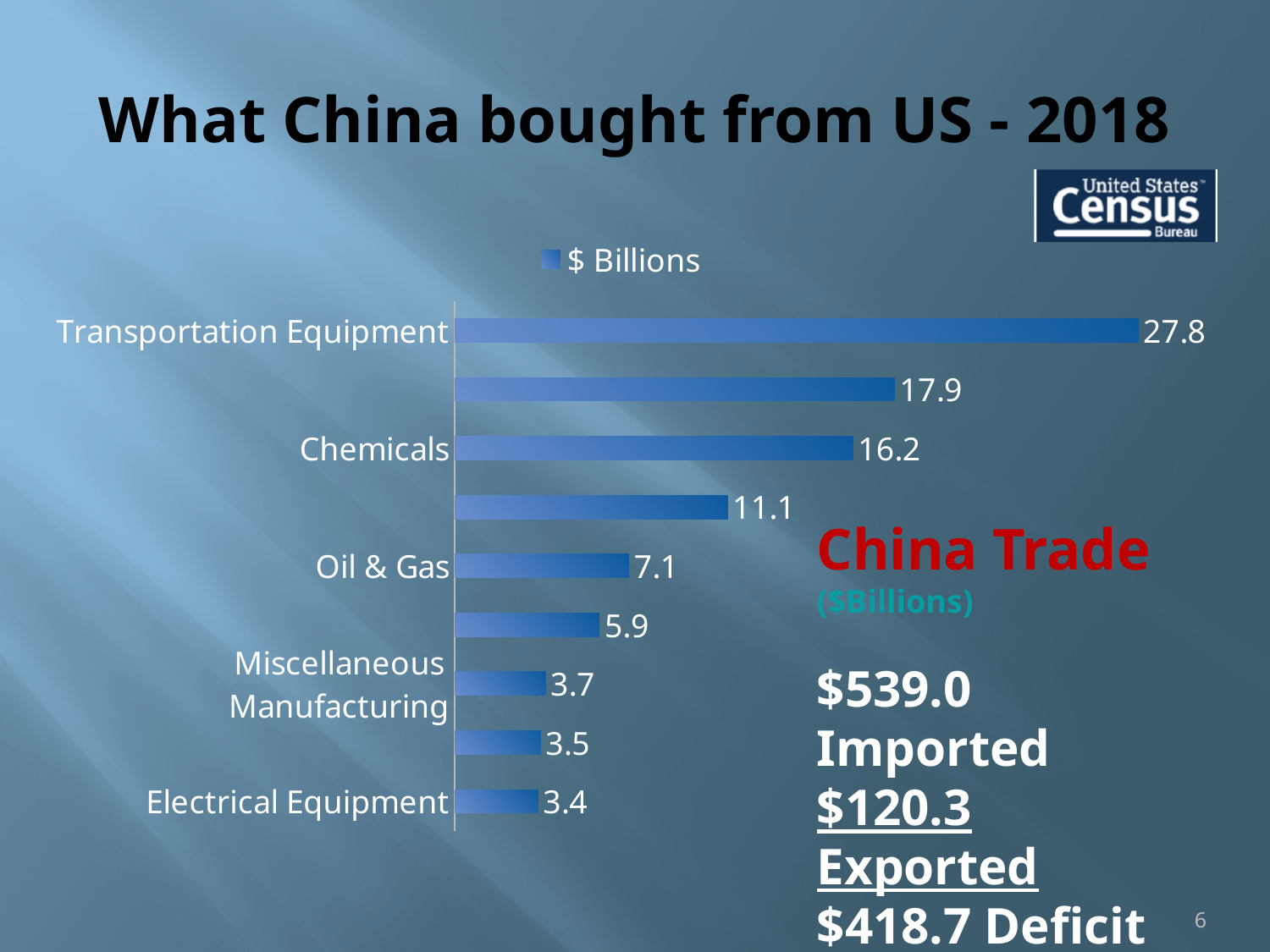
Which is larger, Oil & Gas or Miscellaneous Manufacturing? Oil & Gas What is the value for Oil & Gas? 7.1 What is the value for Chemicals? 16.2 Which category has the lowest value? Electrical Equipment What is the value for Electrical Equipment? 3.4 What is the value for Transportation Equipment? 27.8 What is the difference between Transportation Equipment and Chemicals? 11.6 How many bars are plotted in the chart? 9 Which category has the highest value? Transportation Equipment How many series does the legend list? 1 What is the value for Miscellaneous Manufacturing? 3.7 What kind of chart is shown? Bar chart